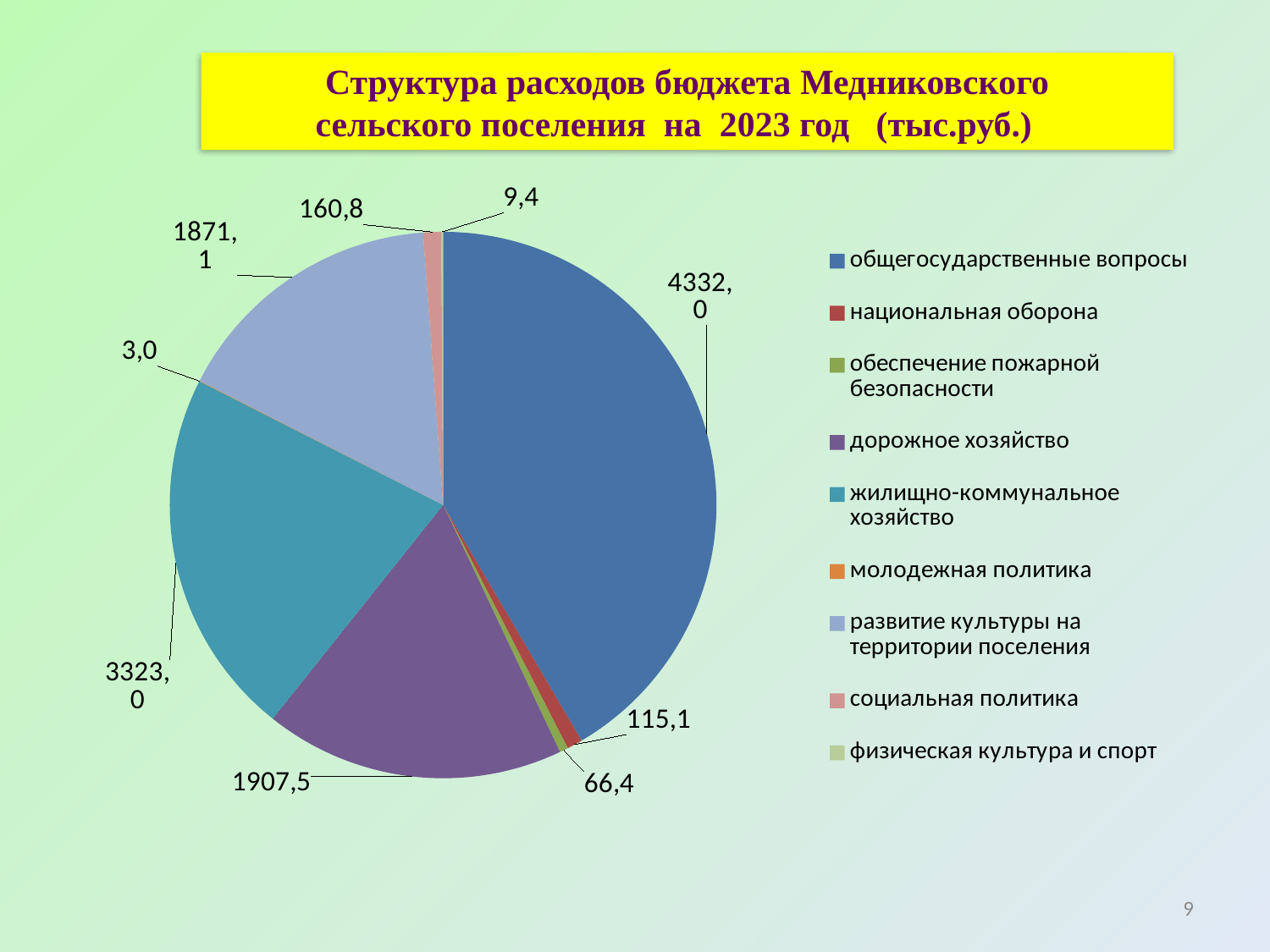
Which is larger: дорожное хозяйство or развитие культуры на территории поселения? дорожное хозяйство What kind of chart is shown on the slide? pie chart What is the difference between the values for общегосударственные вопросы and жилищно-коммунальное хозяйство? 1009,0 What unit is stated in the chart title? тыс.руб. What is the value for дорожное хозяйство? 1907,5 What is the value for жилищно-коммунальное хозяйство? 3323,0 Which category has the largest slice of the pie? общегосударственные вопросы What is the value for общегосударственные вопросы? 4332,0 What is the value for социальная политика? 160,8 How many categories does the legend of the pie chart list? 9 What is the value for национальная оборона? 115,1 Which category has the smallest value in the pie chart? молодежная политика